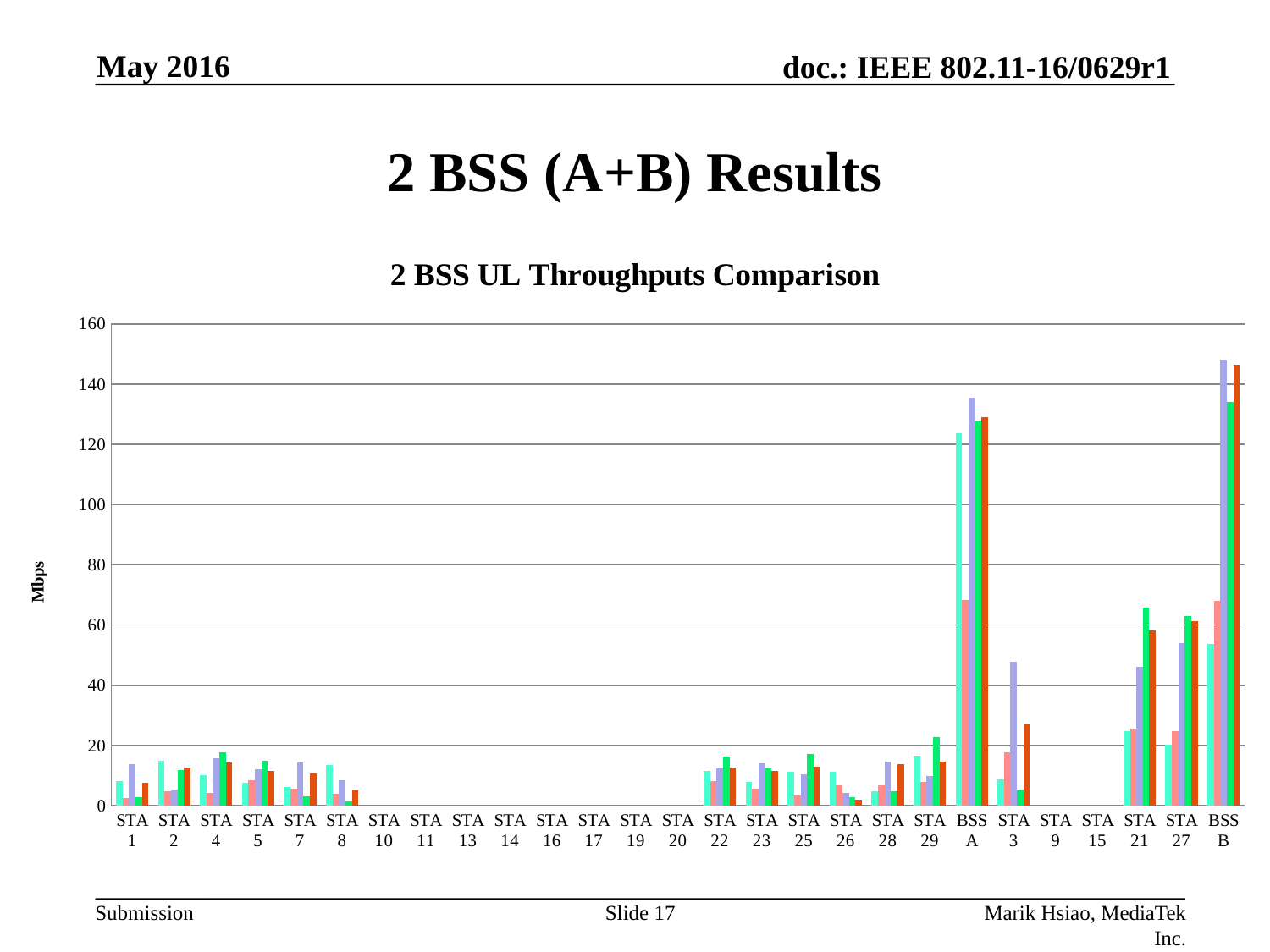
What is the title of the chart? 2 BSS UL Throughputs Comparison What unit is shown on the vertical axis label of the chart? Mbps Is the tallest bar for BSS B greater or less than 140? greater Is the tallest bar for STA 21 greater or less than 60? greater Is the tallest bar for STA 3 greater or less than 40? greater Which has the taller tallest bar, STA 1 or STA 27? STA 27 How many categories are listed along the x axis of the chart? 27 What kind of chart is shown on the slide? bar chart Which category has the tallest bar in the chart? BSS B Which has the taller tallest bar, BSS A or BSS B? BSS B